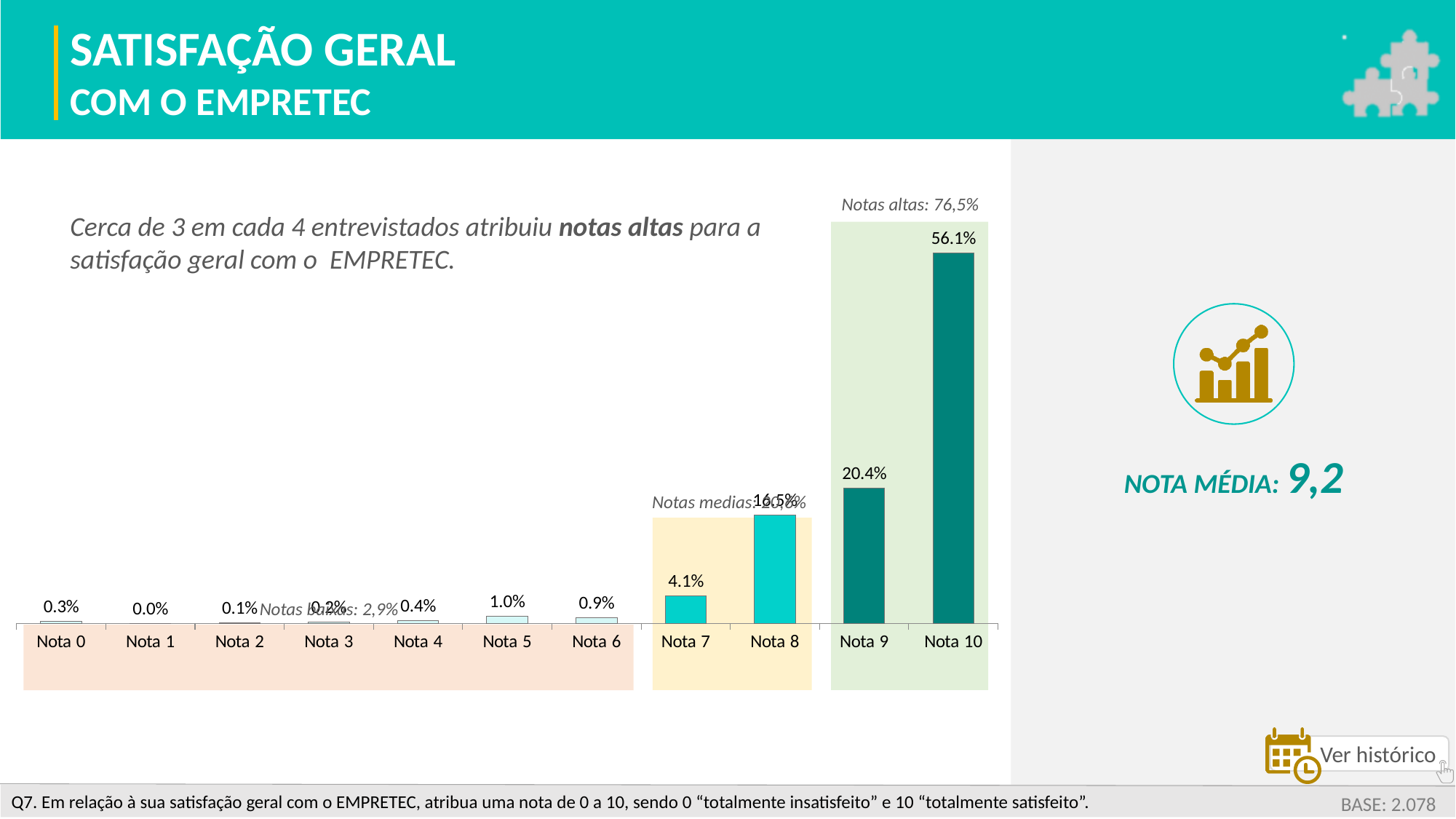
What is the value for Nota 5? 1.0% What share of respondents gave 'Notas altas' according to the label above the green area? 76,5% Which category has the highest value? Nota 10 Which category has the lowest value? Nota 1 What is the difference between the values for Nota 10 and Nota 9? 35.7% What kind of chart is shown on the slide? Bar chart What is the value for Nota 9? 20.4% What is the value for Nota 7? 4.1% How many categories are shown on the x axis? 11 Which is larger, the value for Nota 8 or the value for Nota 9? Nota 9 What is the value for Nota 10? 56.1% What is the 'Nota média' shown on the right of the slide? 9,2